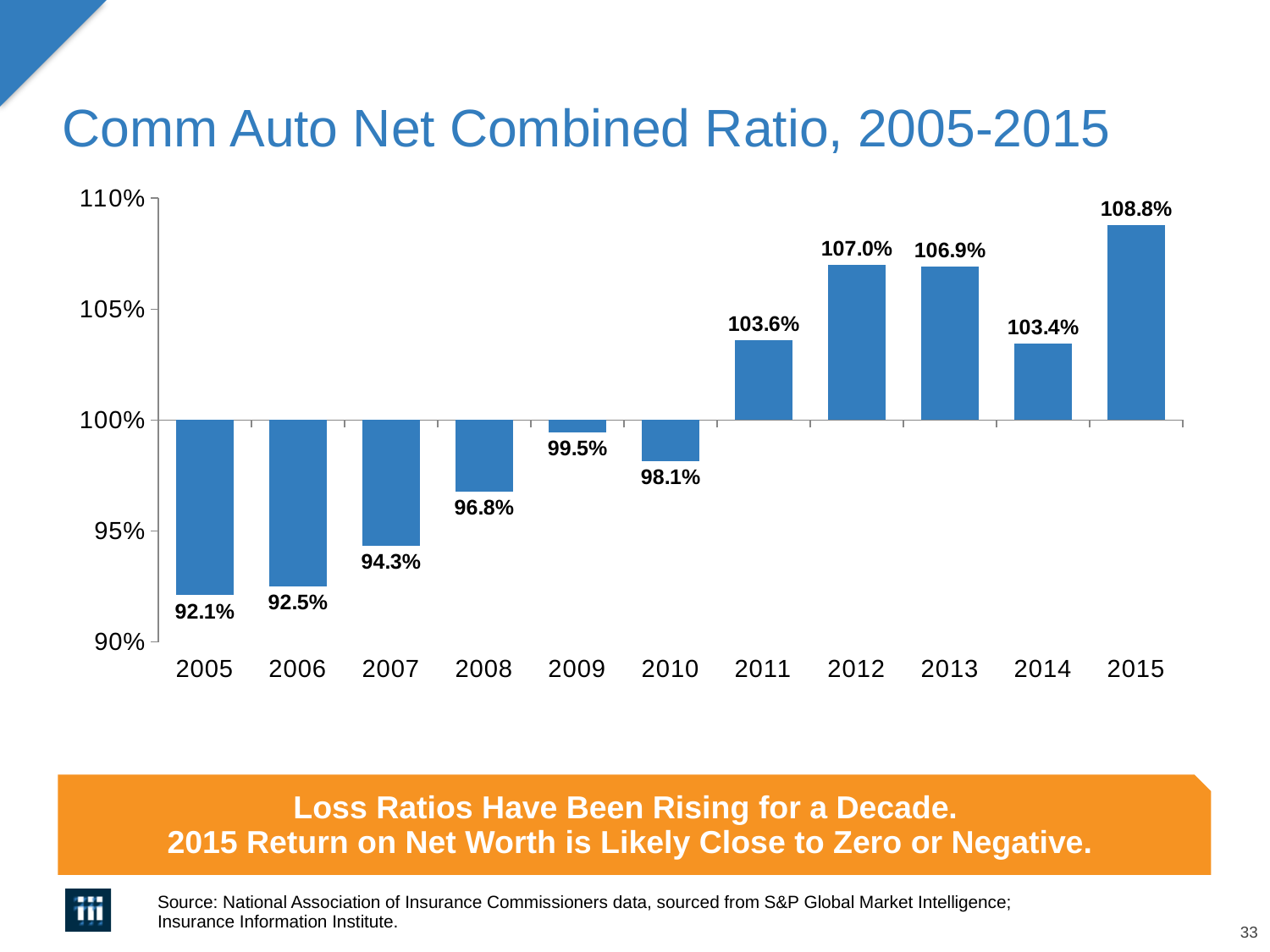
What is the combined ratio for 2010? 98.1% What kind of chart is shown on the slide? Bar chart Which year has the highest combined ratio? 2015 What is the difference between the 2012 and 2013 combined ratios? 0.1 percentage points What is the title of the chart? Comm Auto Net Combined Ratio, 2005-2015 How many years are shown on the chart? 11 What is the difference between the 2015 and 2005 combined ratios? 16.7 percentage points Which year has a higher combined ratio, 2011 or 2014? 2011 Is the value for 2008 greater or less than 100%? less What is the combined ratio for 2014? 103.4% Which year has the lowest combined ratio? 2005 What is the combined ratio for 2005? 92.1%